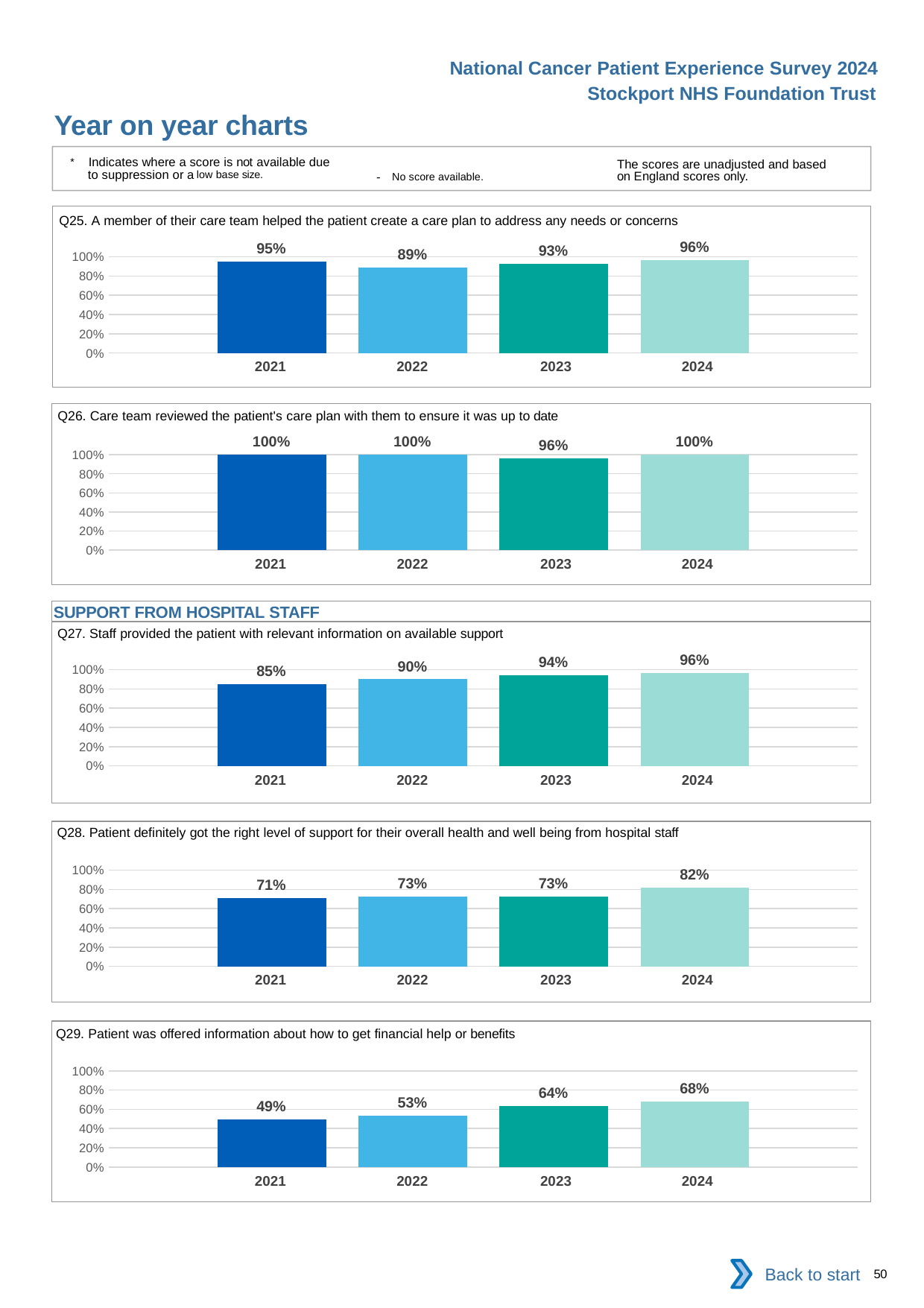
In the Q25 chart (care team helped create a care plan), what is the value for 2022? 89% In the Q26 chart (care team reviewed the care plan), what is the value for 2021? 100% In the Q28 chart (right level of support for overall health and well being), what is the value for 2024? 82% In the Q29 chart (information about financial help or benefits), what is the value for 2021? 49% What type of chart is the Q25 chart (care team helped create a care plan)? bar chart In the Q29 chart (information about financial help or benefits), what is the difference between the 2023 and 2022 values? 11 percentage points In the Q26 chart (care team reviewed the care plan), which year has the lowest value? 2023 In the Q25 chart (care team helped create a care plan), which year has the highest value? 2024 In the Q27 chart (staff provided information on available support), do the values rise or fall from 2021 to 2024? rise How many years are shown on the x axis of the Q29 chart (information about financial help or benefits)? 4 In the Q28 chart (right level of support for overall health and well being), which is larger, the 2021 value or the 2024 value? 2024 In the Q27 chart (staff provided information on available support), what is the difference between the 2024 and 2021 values? 11 percentage points